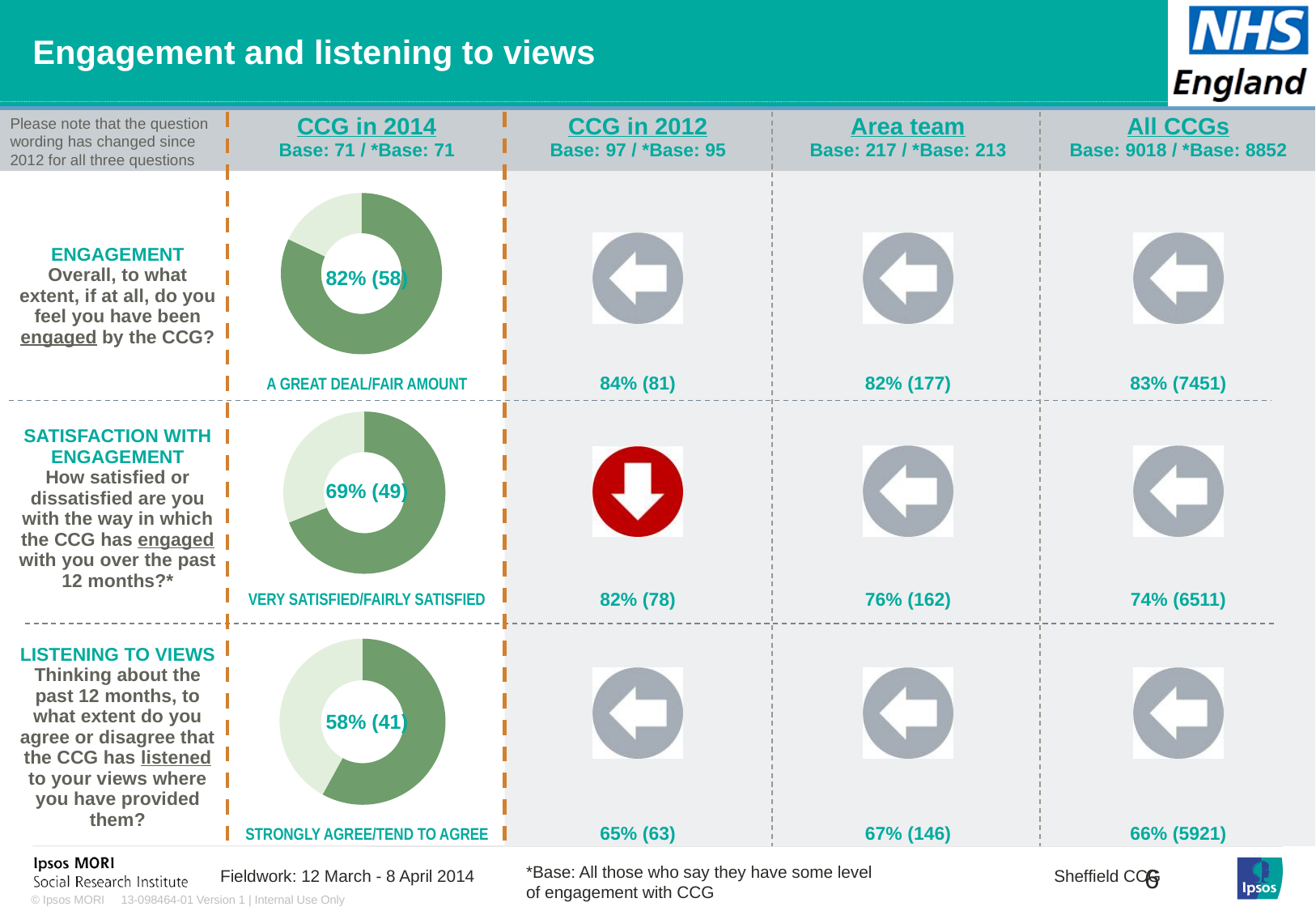
What is the difference in percentage points between the Engagement donut (82%) and the Listening to Views donut (58%) for CCG in 2014? 24 percentage points For CCG in 2014, which is larger: the Engagement percentage or the Satisfaction with Engagement percentage? Engagement What kind of chart is used in the CCG in 2014 column to show the results? Pie chart (donut) Is the Satisfaction with Engagement value for CCG in 2014 greater or less than 50%? greater Which of the three CCG in 2014 donut charts shows the highest percentage? Engagement In the CCG in 2014 column, what value is shown in the Engagement donut chart? 82% (58) How many donut charts are shown on the slide? 3 In the CCG in 2014 column, what value is shown in the Listening to Views donut chart? 58% (41) In the CCG in 2014 column, what value is shown in the Satisfaction with Engagement donut chart? 69% (49) What label appears beneath the Engagement donut chart in the CCG in 2014 column? A GREAT DEAL/FAIR AMOUNT Which of the three CCG in 2014 donut charts shows the lowest percentage? Listening to Views What is the difference in percentage points between the Satisfaction with Engagement value for CCG in 2012 (82%) and CCG in 2014 (69%)? 13 percentage points